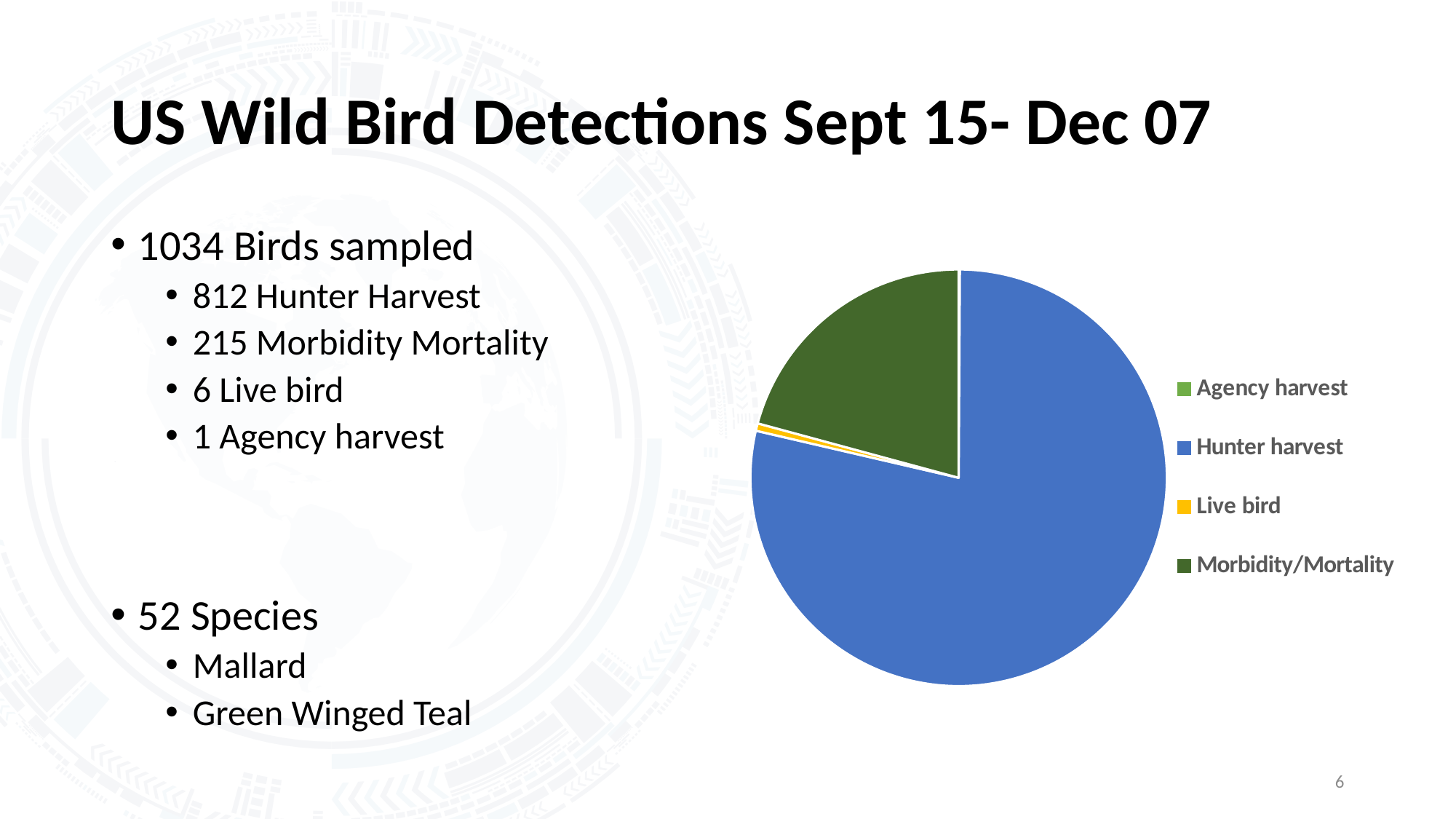
According to the slide, how many birds were in the Live bird category shown in the pie chart? 6 How many categories does the pie chart's legend list? 4 What kind of chart is shown on the slide? pie chart Which category has the smallest slice of the pie chart? Agency harvest What colour is the Hunter harvest slice in the pie chart? blue Which category takes up the largest slice of the pie chart? Hunter harvest Using the counts given on the slide, what is the difference between the Hunter harvest and Morbidity/Mortality categories? 597 According to the slide, how many birds were in the Hunter harvest category shown in the pie chart? 812 Which slice is larger in the pie chart, Morbidity/Mortality or Live bird? Morbidity/Mortality Which legend entry is shown in yellow in the pie chart? Live bird According to the slide, how many birds were in the Morbidity/Mortality category shown in the pie chart? 215 Using the counts given on the slide, what is the total number of birds represented by the pie chart? 1034